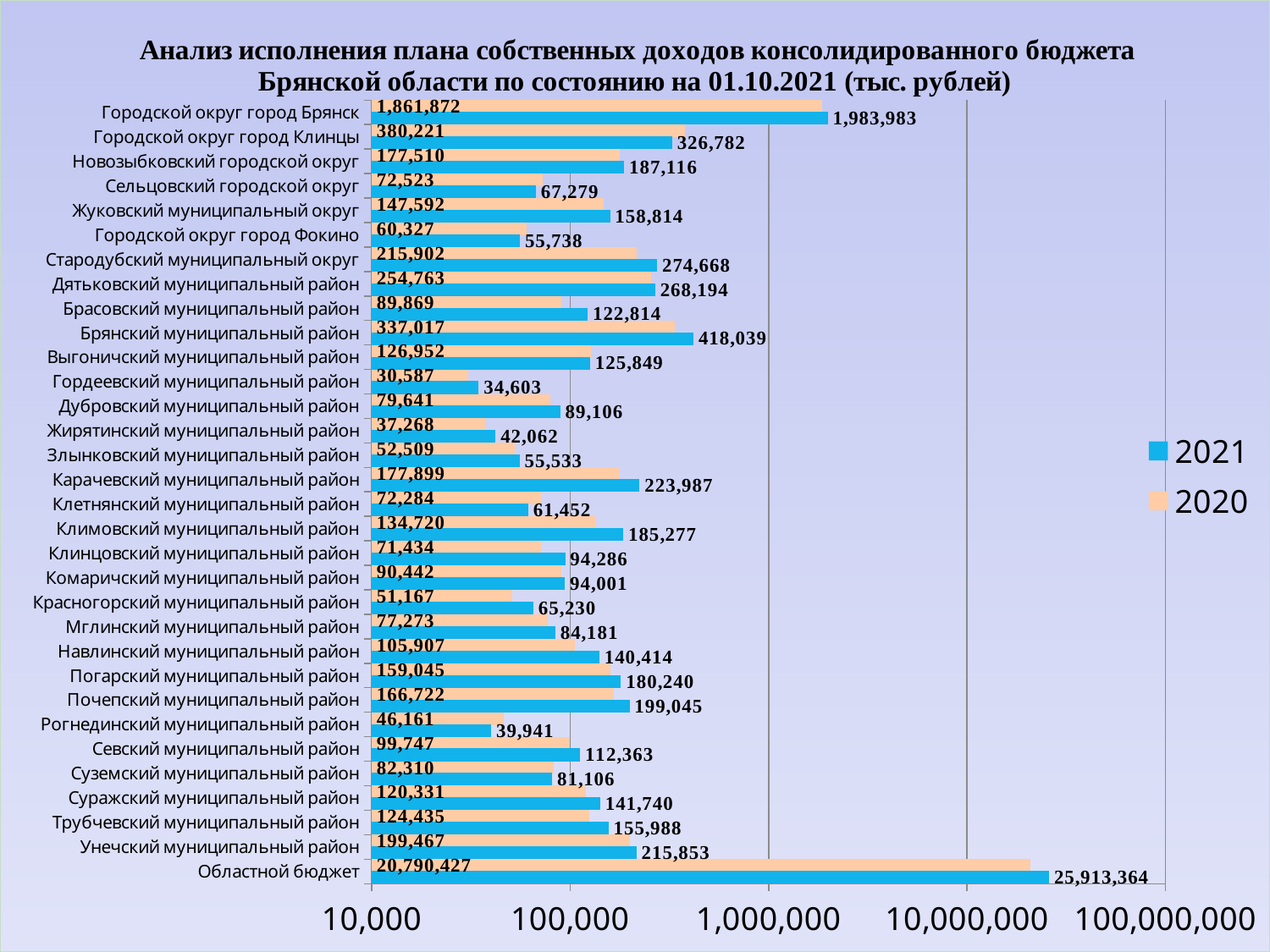
What is the 2020 value for Гордеевский муниципальный район? 30,587 Which category has the lowest 2020 value? Гордеевский муниципальный район How many categories are plotted on the chart? 32 What is the difference between the 2021 and 2020 values for Брянский муниципальный район? 81,022 What is the 2020 value for Брянский муниципальный район? 337,017 How many series does the legend list? 2 What is the 2021 value for Областной бюджет? 25,913,364 What is the 2021 value for Городской округ город Брянск? 1,983,983 Which colour represents the 2020 series in the legend? orange Which category has the highest 2021 value? Областной бюджет Which is larger for Сельцовский городской округ: the 2021 value or the 2020 value? 2020 What kind of chart is shown on the slide? bar chart